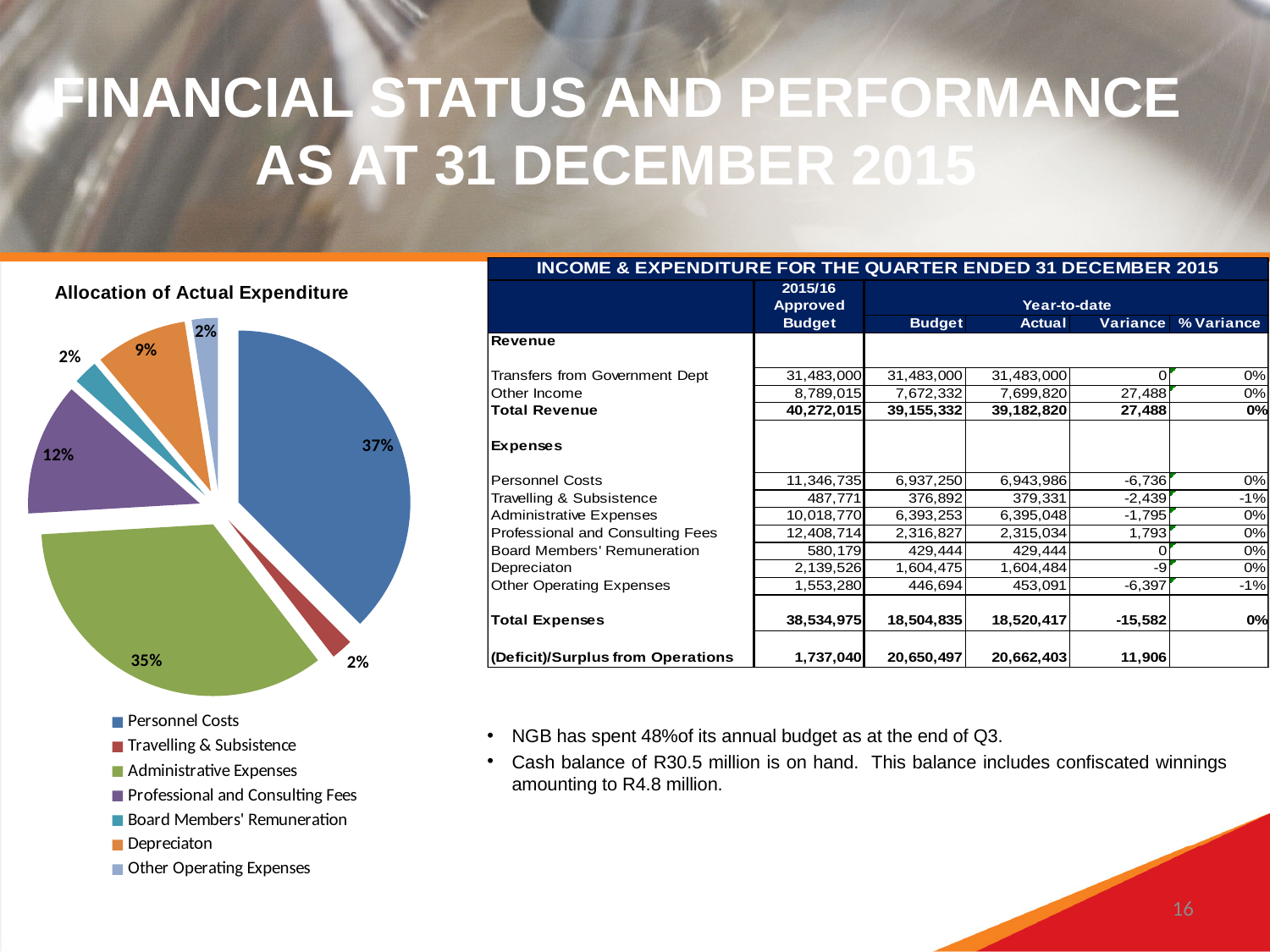
In the "Allocation of Actual Expenditure" pie chart, what share is Administrative Expenses? 35% In the "Allocation of Actual Expenditure" pie chart, what share is Depreciaton? 9% In the "Allocation of Actual Expenditure" pie chart, which is larger: Professional and Consulting Fees or Depreciaton? Professional and Consulting Fees In the "Allocation of Actual Expenditure" pie chart, what is the difference between the Personnel Costs share and the Administrative Expenses share? 2% In the "Allocation of Actual Expenditure" pie chart, what share is Professional and Consulting Fees? 12% What type of chart is the "Allocation of Actual Expenditure" chart? pie chart In the "Allocation of Actual Expenditure" pie chart, what share is Travelling & Subsistence? 2% What is the title of the pie chart on the slide? Allocation of Actual Expenditure Which category has the largest slice in the "Allocation of Actual Expenditure" pie chart? Personnel Costs In the "Allocation of Actual Expenditure" pie chart, what share is Personnel Costs? 37% How many categories does the legend of the "Allocation of Actual Expenditure" pie chart list? 7 In the "Allocation of Actual Expenditure" pie chart, what colour is the Administrative Expenses slice? green